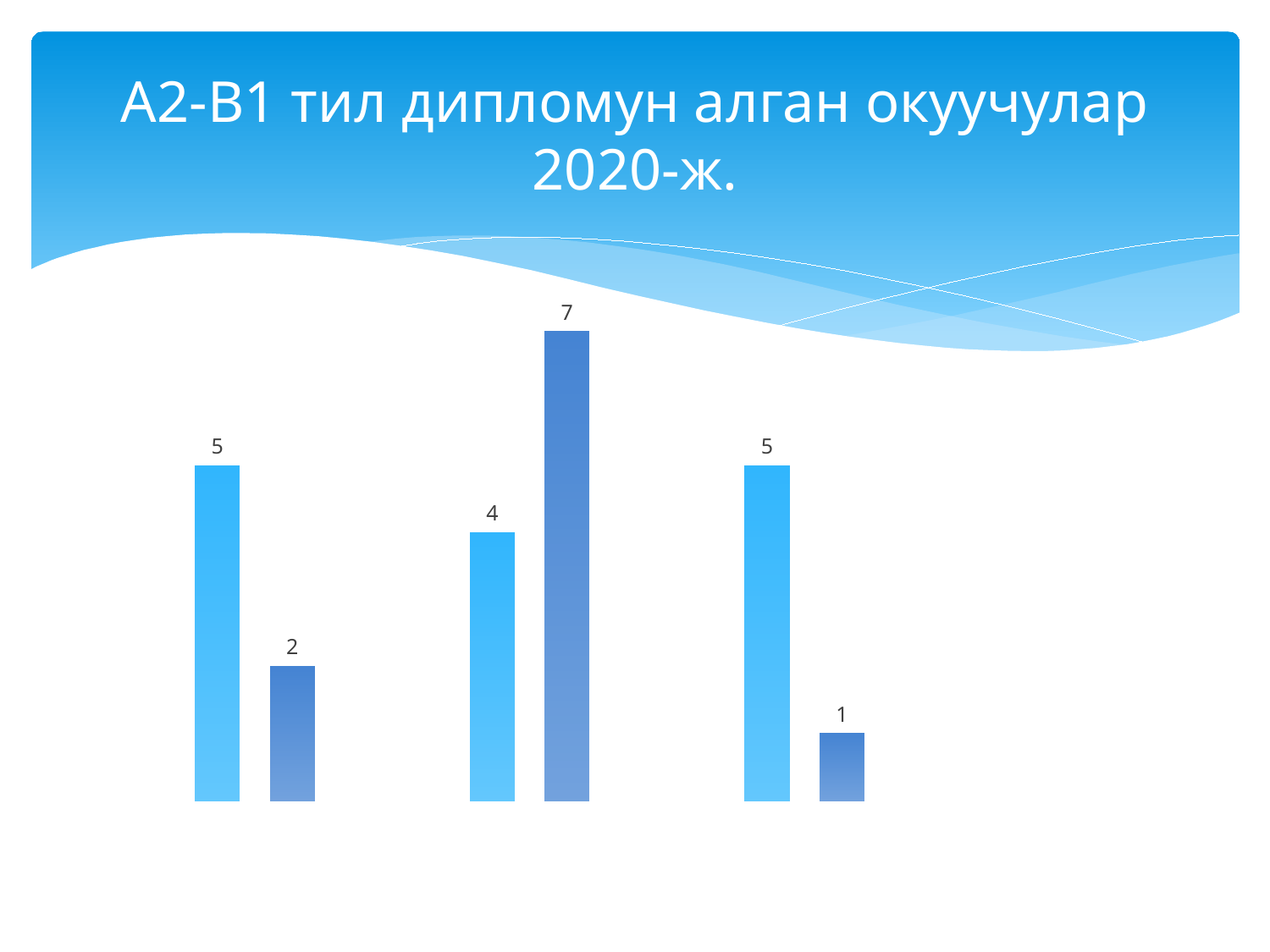
What is the value of the light blue bar in the rightmost group? 5 How many bars are plotted in the chart? 6 What is the value of the dark blue bar in the leftmost group? 2 What kind of chart is shown on the slide? bar chart What is the value of the shortest bar in the chart? 1 What is the value of the tallest bar in the chart? 7 What is the title of the chart on the slide? А2-В1 тил дипломун алган окуучулар 2020-ж. How many groups of bars does the chart show? 3 What is the value of the light blue bar in the leftmost group? 5 What is the difference between the two bars in the middle group? 3 In the rightmost group, which bar is larger, the light blue one or the dark blue one? the light blue one What is the value of the dark blue bar in the middle group? 7